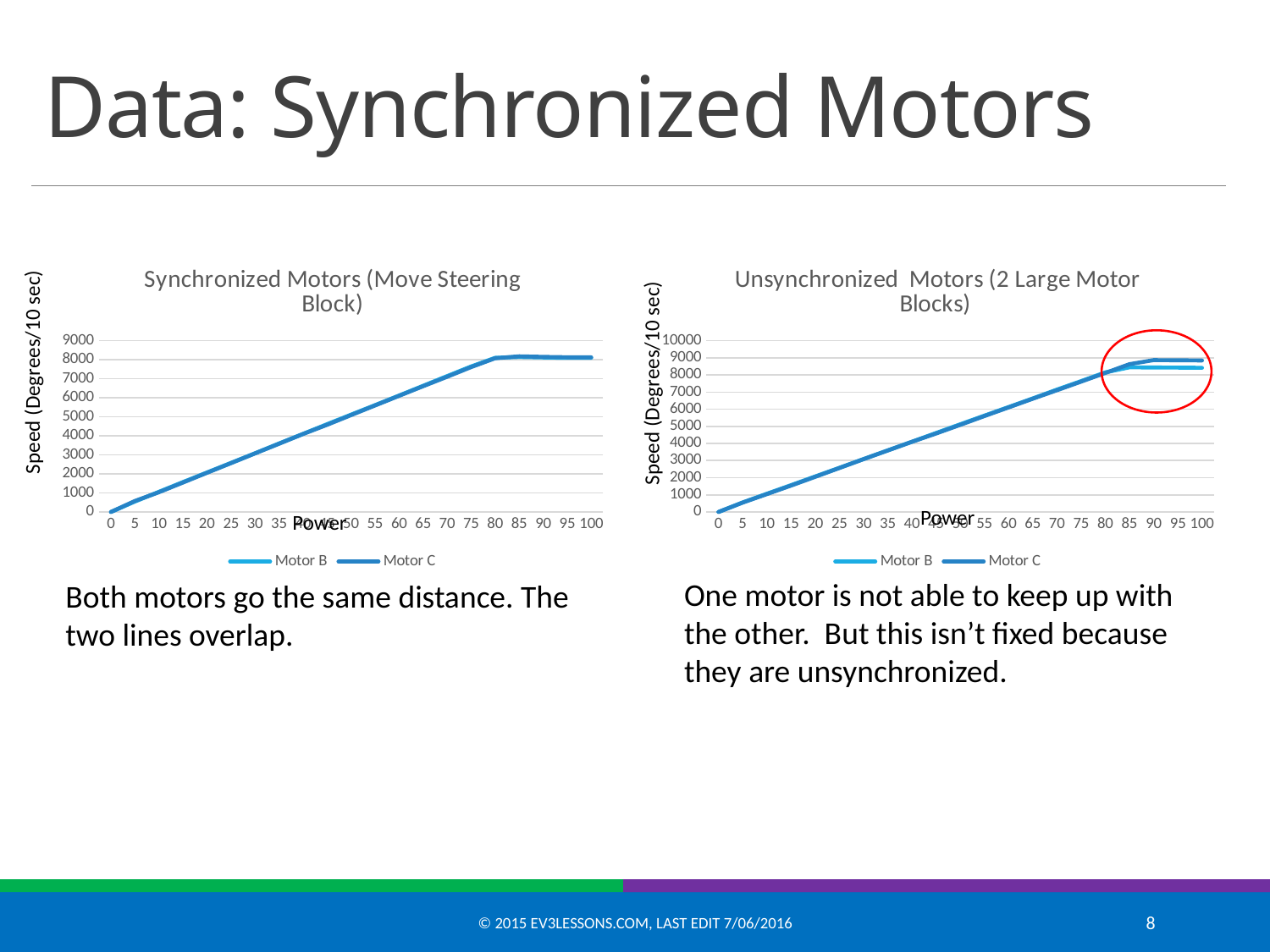
In the 'Synchronized Motors (Move Steering Block)' chart, what are the two series named in the legend? Motor B and Motor C In the 'Synchronized Motors (Move Steering Block)' chart, is the value at power 100 greater or less than 7000? greater In the 'Unsynchronized Motors (2 Large Motor Blocks)' chart, do the values rise or fall as power increases from 0 to 80? rise In the 'Unsynchronized Motors (2 Large Motor Blocks)' chart, which series has the higher value at power 100, Motor B or Motor C? Motor C What is the y-axis label of the 'Unsynchronized Motors (2 Large Motor Blocks)' chart? Speed (Degrees/10 sec) How many series does the legend of the 'Unsynchronized Motors (2 Large Motor Blocks)' chart list? 2 In the 'Unsynchronized Motors (2 Large Motor Blocks)' chart, is the Motor C value at power 100 greater or less than 8000? greater In the 'Synchronized Motors (Move Steering Block)' chart, is the value at power 30 greater or less than 2000? greater What kind of chart is the 'Synchronized Motors (Move Steering Block)' chart? line chart How many power values are marked on the x axis of the 'Synchronized Motors (Move Steering Block)' chart? 21